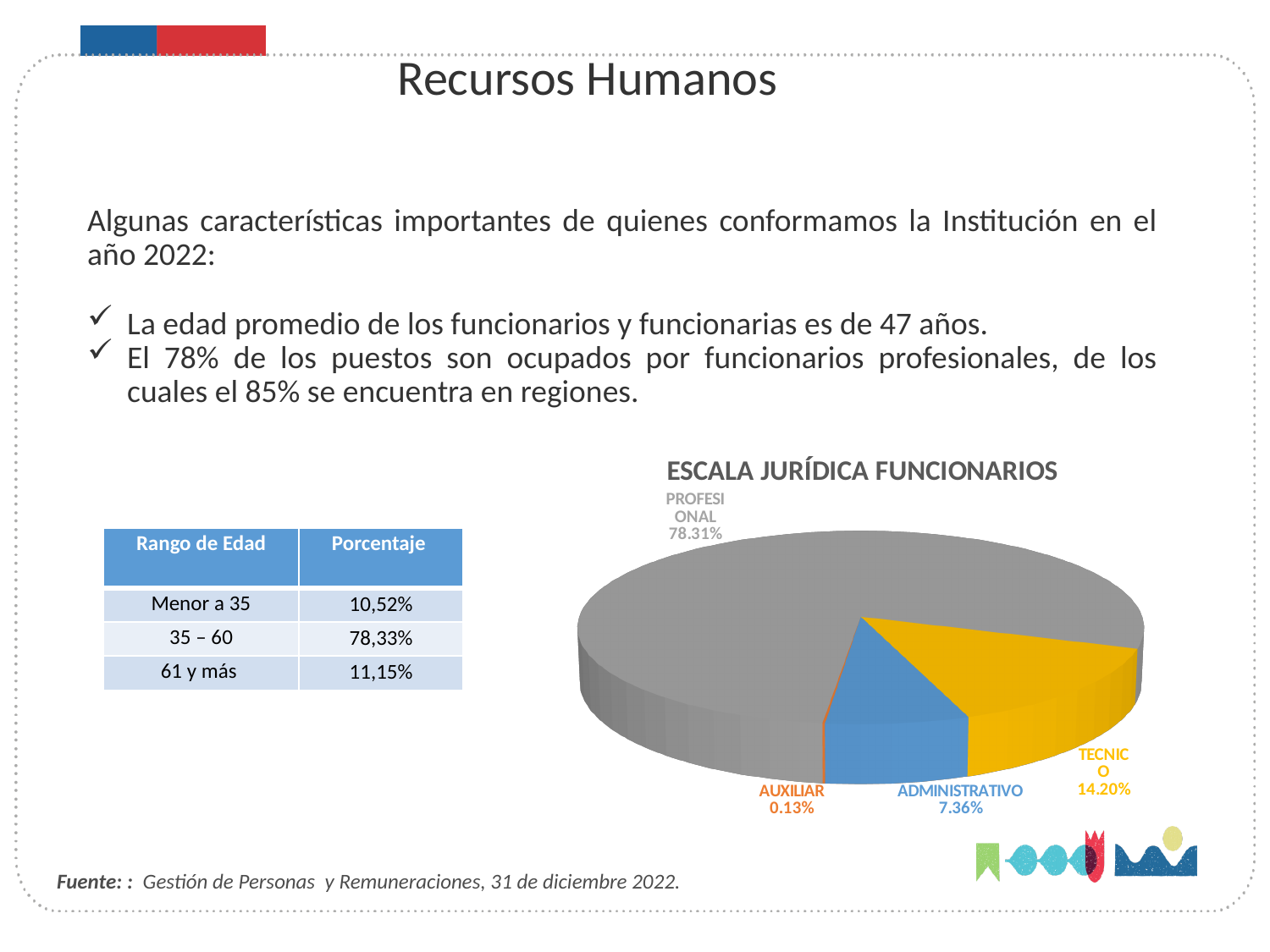
Which is larger, the TECNICO slice or the ADMINISTRATIVO slice? TECNICO What type of chart is shown on the slide? pie chart What share of the pie does PROFESIONAL represent? 78.31% Which category has the largest slice of the pie? PROFESIONAL What is the difference in percentage points between the TECNICO and ADMINISTRATIVO slices? 6.84 What is the title of the chart? ESCALA JURÍDICA FUNCIONARIOS What share of the pie does TECNICO represent? 14.20% What share of the pie does AUXILIAR represent? 0.13% Which category has the smallest slice of the pie? AUXILIAR How many slices does the pie chart have? 4 What colour is the PROFESIONAL slice? grey